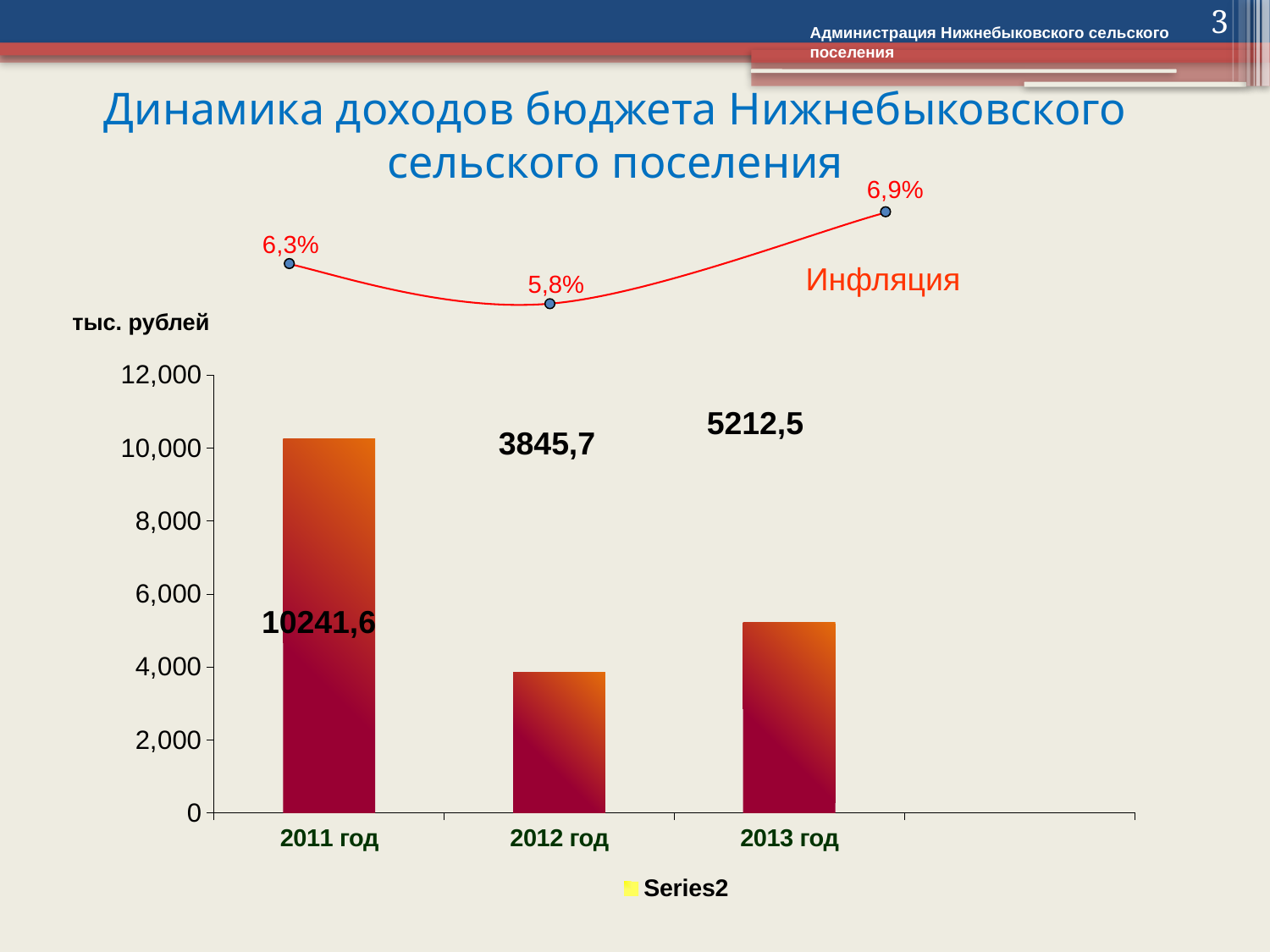
What is the value for 2012 год? 3845,7 What is the value for 2011 год? 10241,6 What kind of chart is used to show the budget revenues? bar chart Which year has the lowest value? 2012 год What is the value for 2013 год? 5212,5 What inflation rate (Инфляция) is shown for 2013? 6,9% Which is larger, the value for 2011 год or the value for 2013 год? 2011 год Is the value for 2012 год greater or less than 4,000? less How many years are shown on the x axis of the bar chart? 3 Which year has the highest value? 2011 год What is the difference between the values for 2013 год and 2012 год? 1366,8 What unit is given for the y axis of the bar chart? тыс. рублей